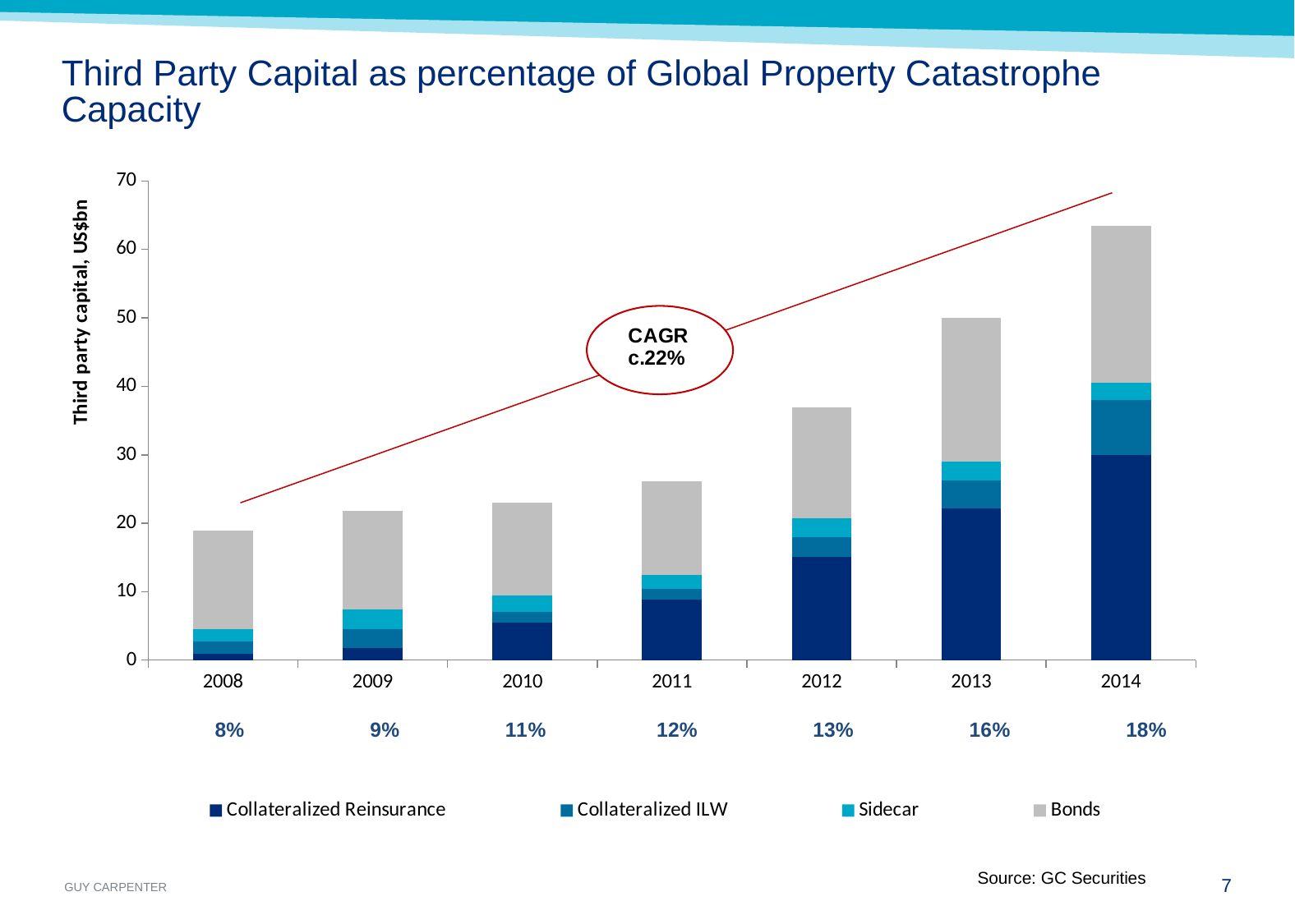
What percentage is shown beneath the 2010 bar? 11% What CAGR is stated in the annotation on the chart? c.22% Is the total third party capital for 2014 greater or less than 60? greater What percentage is shown beneath the 2008 bar? 8% Which year has the highest total third party capital? 2014 What kind of chart is shown on the slide? Stacked bar chart Do the total bar heights rise or fall from 2008 to 2014? Rise How many years are shown on the x axis of the chart? 7 How many series does the chart's legend list? 4 What percentage is shown beneath the 2014 bar? 18% Which year has the lowest total third party capital? 2008 Is the total third party capital for 2012 greater or less than 40? less